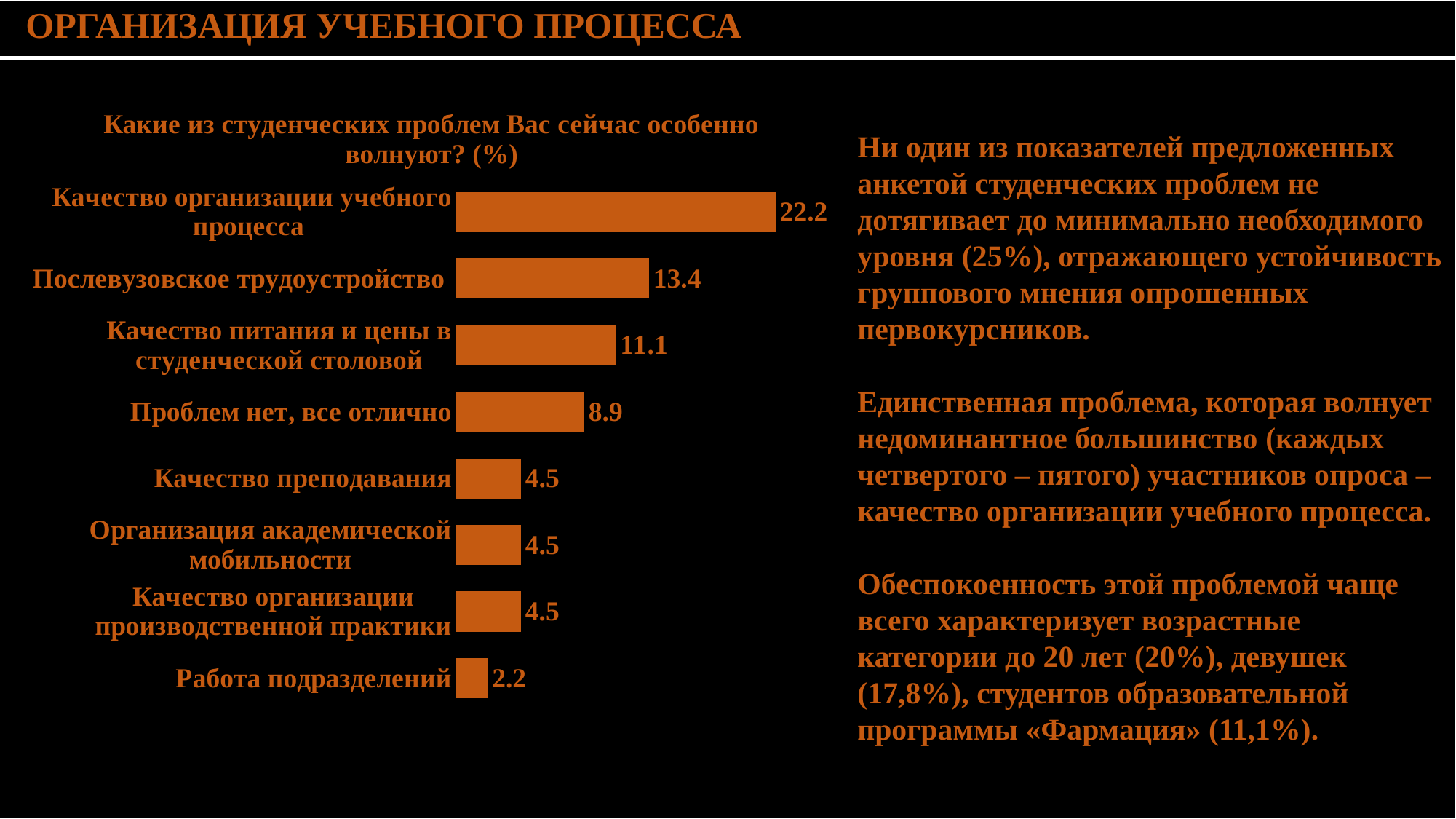
How many categories have a value of 4.5? 3 Which category has the lowest value? Работа подразделений Which category has the highest value? Качество организации учебного процесса What is the value for "Качество организации учебного процесса"? 22.2 Which is larger: the value for "Проблем нет, все отлично" or the value for "Качество преподавания"? Проблем нет, все отлично What is the value for "Послевузовское трудоустройство"? 13.4 What kind of chart is shown on the slide? Bar chart What is the difference between the values for "Качество организации учебного процесса" and "Послевузовское трудоустройство"? 8.8 What is the value for "Качество питания и цены в студенческой столовой"? 11.1 What is the title of the chart? Какие из студенческих проблем Вас сейчас особенно волнуют? (%) What is the value for "Работа подразделений"? 2.2 How many categories are shown in the chart? 8